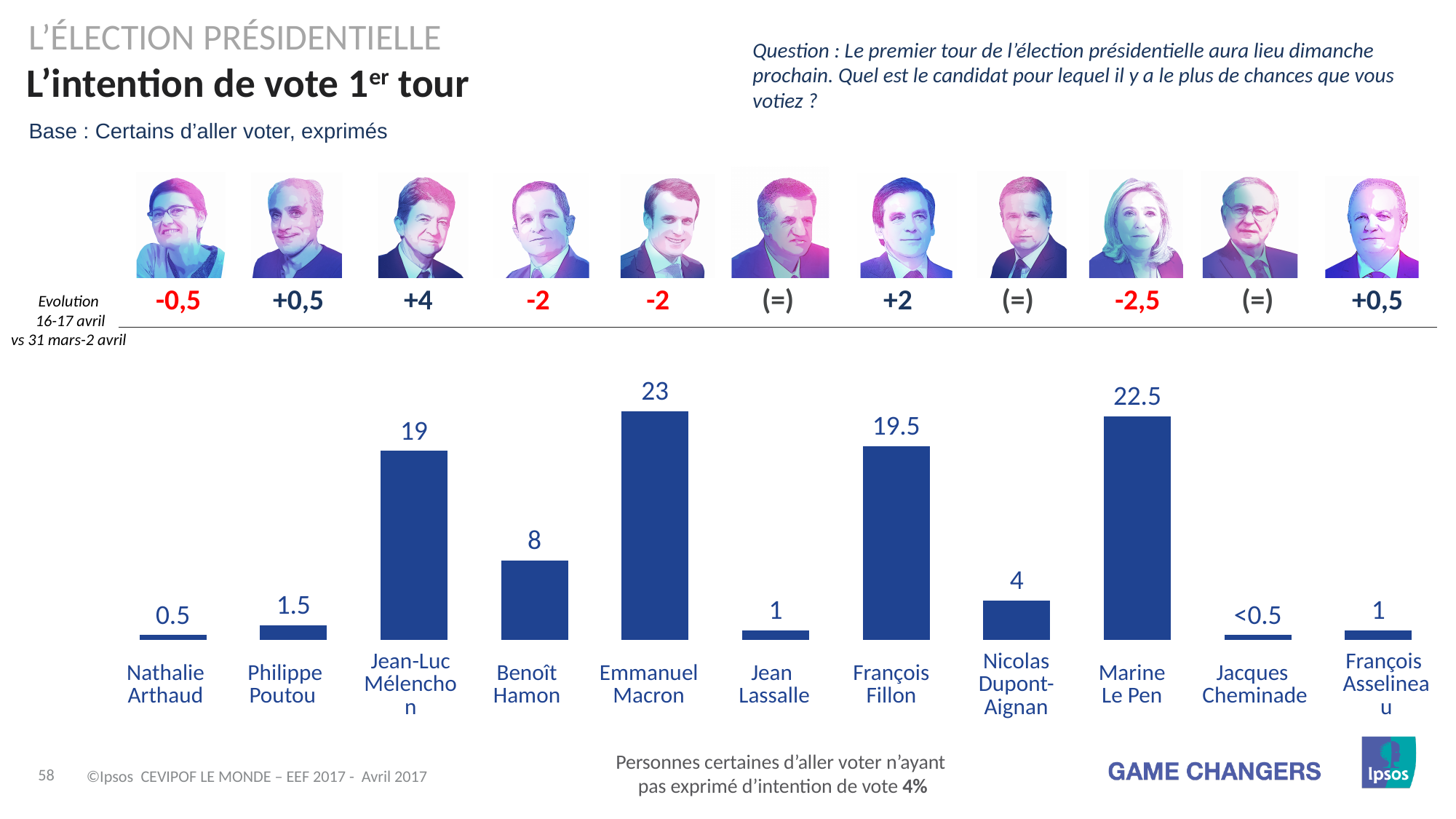
Which is larger, the value for Nicolas Dupont-Aignan or the value for Philippe Poutou? Nicolas Dupont-Aignan What is the difference between the values for Jean-Luc Mélenchon and Benoît Hamon? 11 How many candidates are shown in the chart? 11 What evolution is shown above Jean-Luc Mélenchon's bar? +4 What is the value for Benoît Hamon? 8 What kind of chart is shown on the slide? Bar chart Which candidate has the highest value? Emmanuel Macron What is the value for Emmanuel Macron? 23 What is the value shown for Jacques Cheminade? <0.5 Which is larger, the value for Marine Le Pen or the value for François Fillon? Marine Le Pen What is the difference between the values for Emmanuel Macron and Marine Le Pen? 0.5 What is the value for François Fillon? 19.5